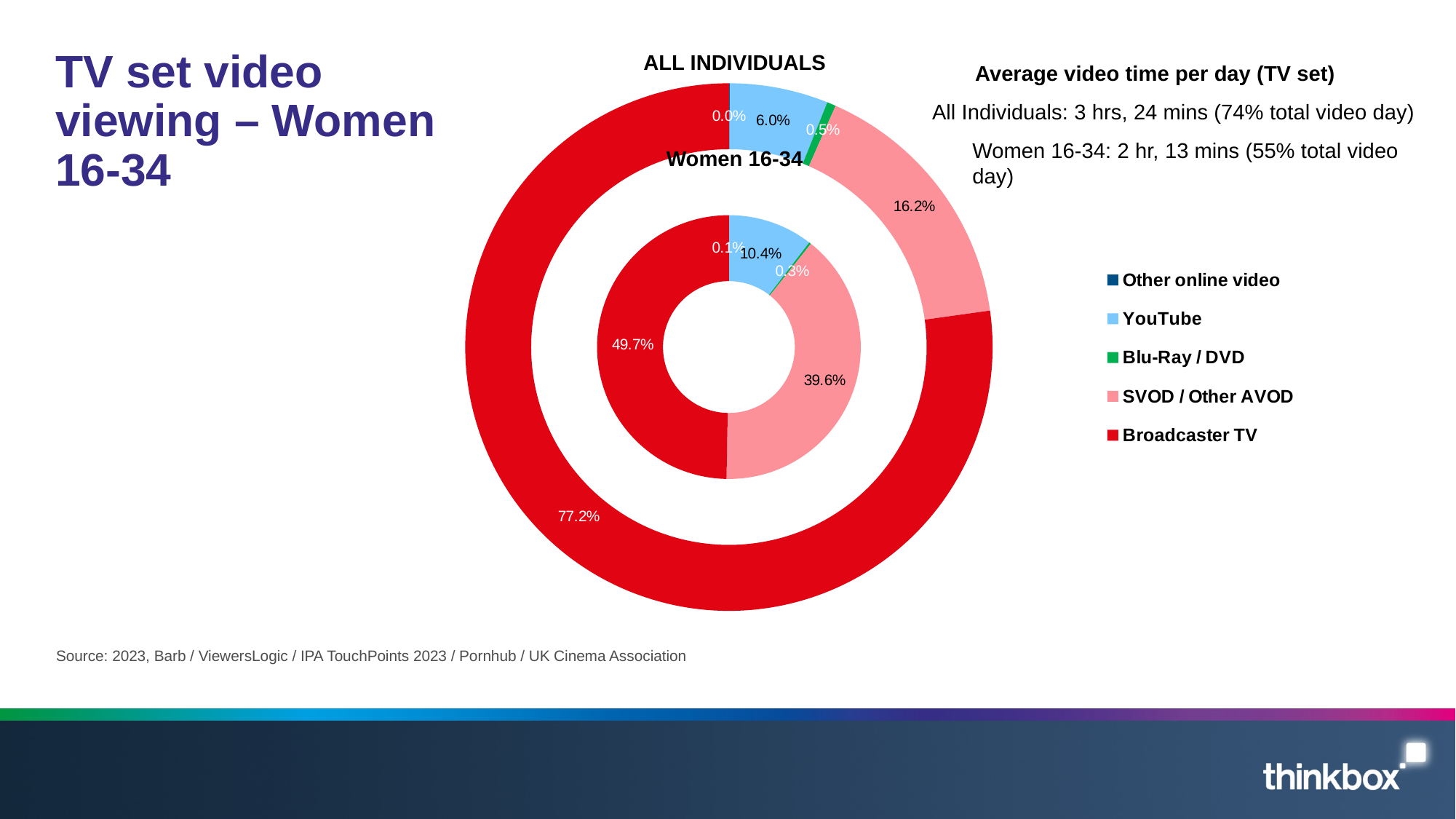
How much larger is the SVOD / Other AVOD share for Women 16-34 than for All Individuals? 23.4 percentage points What is the SVOD / Other AVOD share for All Individuals (outer ring)? 16.2% Which category has the largest share in the Women 16-34 ring? Broadcaster TV Which is larger: the YouTube share for All Individuals or for Women 16-34? Women 16-34 Which colour represents Broadcaster TV in the chart? Red Which category has the smallest share in the All Individuals ring? Other online video What is the YouTube share for Women 16-34 (inner ring)? 10.4% What share of TV set video viewing is Broadcaster TV for All Individuals (outer ring)? 77.2% What kind of chart is shown on the slide? Doughnut chart What share of TV set video viewing is Broadcaster TV for Women 16-34 (inner ring)? 49.7% How many categories does the legend list? 5 What is the Blu-Ray / DVD share for Women 16-34 (inner ring)? 0.3%